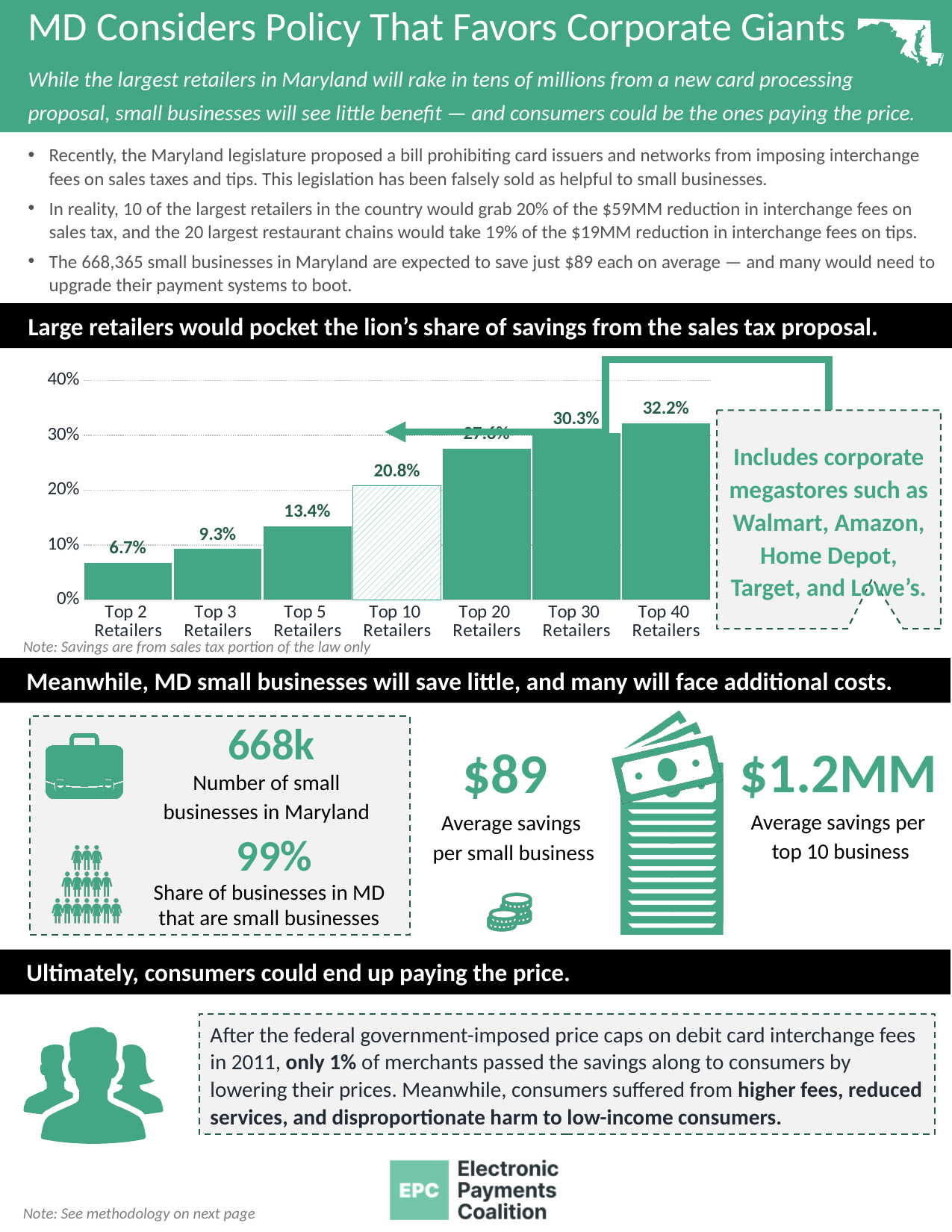
What is the value shown for Top 2 Retailers in the bar chart? 6.7% Is the value for Top 20 Retailers in the bar chart greater or less than 20%? greater Do the values in the bar chart rise or fall from Top 2 Retailers to Top 40 Retailers? rise Which category has the highest value in the bar chart? Top 40 Retailers What kind of chart is used to show the share of savings by retailer group? bar chart What share of savings do the Top 10 Retailers receive in the bar chart? 20.8% Which category has the lowest value in the bar chart? Top 2 Retailers What is the value shown for Top 30 Retailers in the bar chart? 30.3% How many categories are shown on the x axis of the bar chart? 7 Which is larger in the bar chart: the value for Top 10 Retailers or Top 5 Retailers? Top 10 Retailers What is the value shown for Top 40 Retailers in the bar chart? 32.2% What is the difference between the values for Top 5 Retailers and Top 3 Retailers in the bar chart? 4.1%